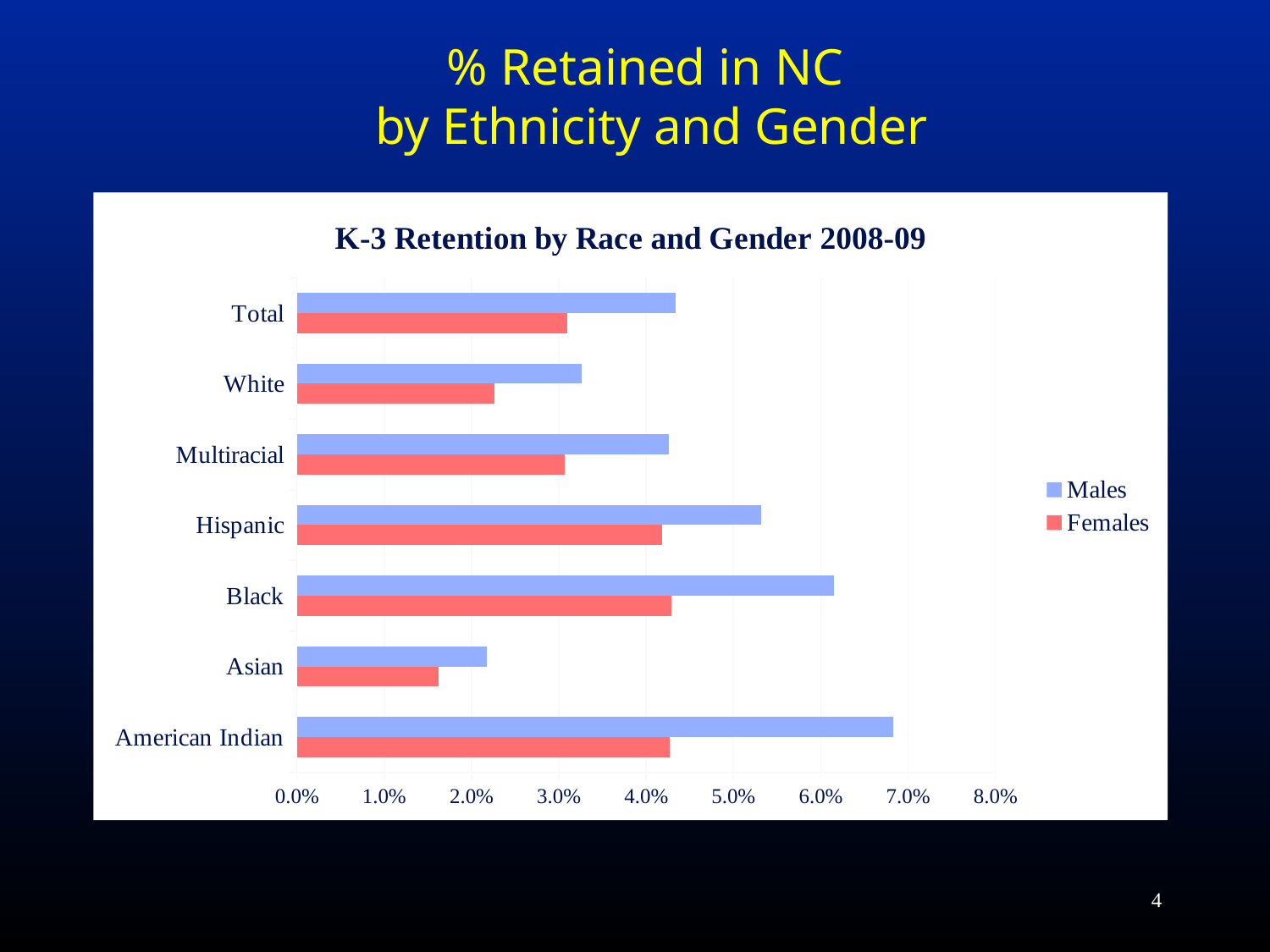
Is the value for White Females greater or less than 3.0%? less How many race/ethnicity categories are plotted on the chart? 7 Is the value for American Indian Males greater or less than 6.0%? greater Which is larger, the Males value for Black or the Males value for Hispanic? Black Which category has the lowest value for Males? Asian Is the value for Asian Females greater or less than 2.0%? less What is the title printed inside the chart area? K-3 Retention by Race and Gender 2008-09 Which category has the highest value for Males? American Indian Which category has the lowest value for Females? Asian How many series does the legend list? 2 What kind of chart is shown on the slide? bar chart